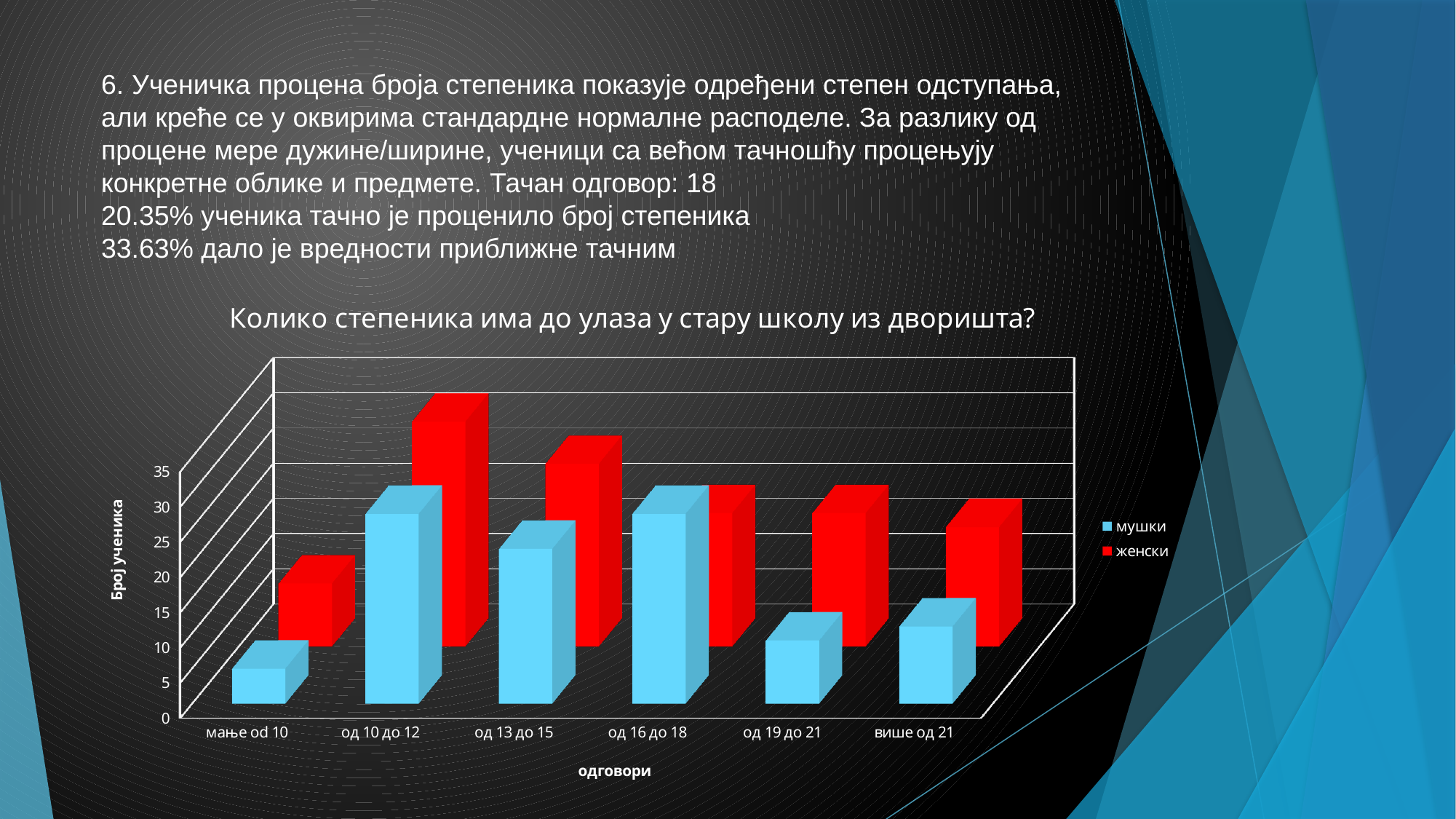
How many series does the legend list? 2 What is the label of the vertical axis? Број ученика How many categories are shown on the x axis? 6 What kind of chart is shown on the slide? bar chart For which category is the женски series highest? од 10 до 12 Is the женски value for од 10 до 12 greater or less than 25? greater Is the мушки value for од 19 до 21 greater or less than 15? less Is the мушки value for мање од 10 greater or less than 10? less What is the title of the chart? Колико степеника има до улаза у стару школу из дворишта? For which category is the женски series lowest? мање од 10 For which category is the мушки series lowest? мање од 10 For the category мање од 10, which series has the larger value, мушки or женски? женски